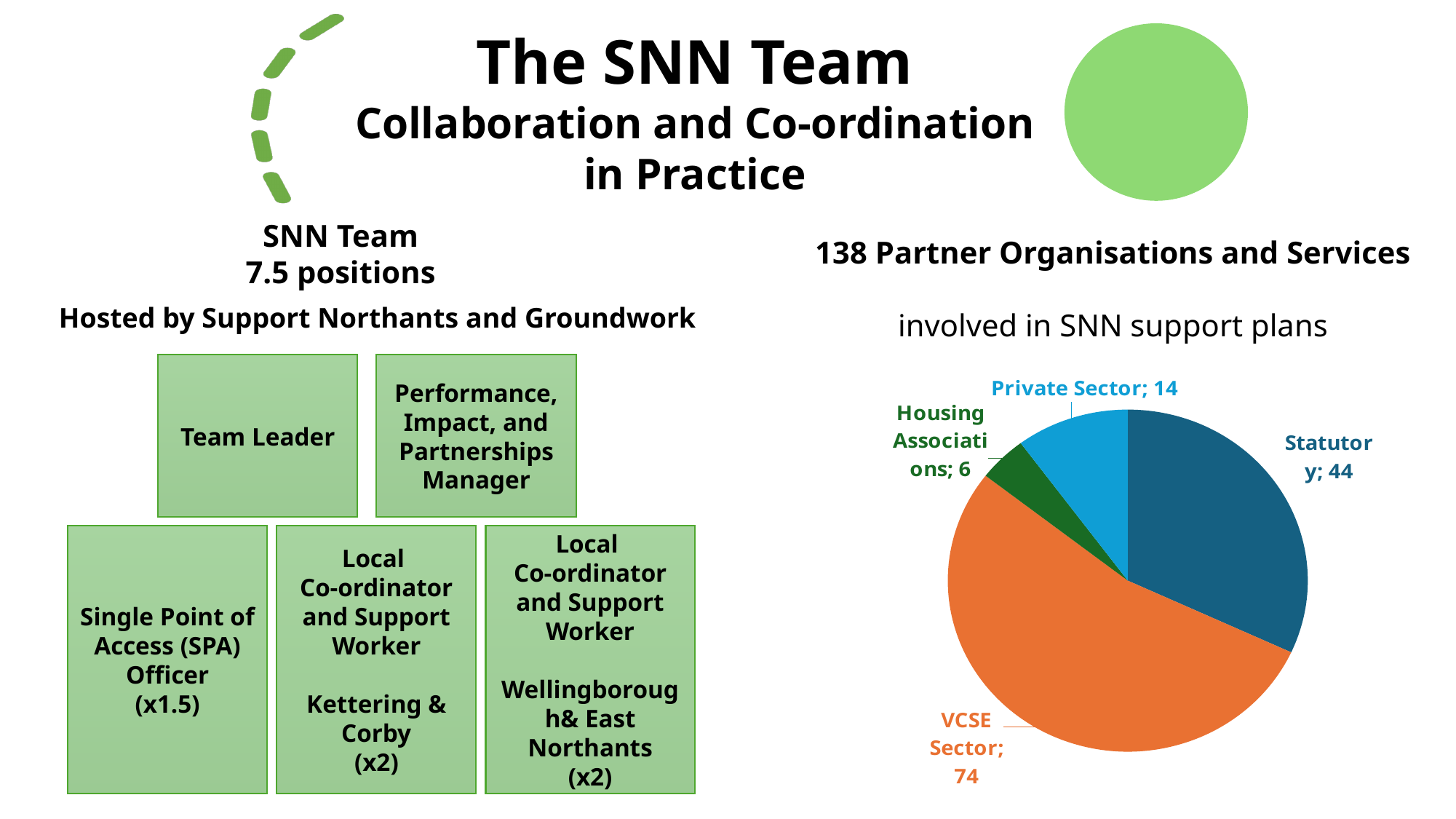
What is the value for the Statutory slice in the pie chart? 44 How many slices does the pie chart have? 4 What kind of chart is shown on the slide? pie chart What is the total of all the slices in the pie chart? 138 Which category has the smallest slice in the pie chart? Housing Associations What colour is the VCSE Sector slice in the pie chart? orange What is the value for the Housing Associations slice in the pie chart? 6 What is the value for the VCSE Sector slice in the pie chart? 74 What is the value for the Private Sector slice in the pie chart? 14 Which is larger in the pie chart, Private Sector or Housing Associations? Private Sector What is the difference between the VCSE Sector value and the Statutory value in the pie chart? 30 Which category has the largest slice in the pie chart? VCSE Sector